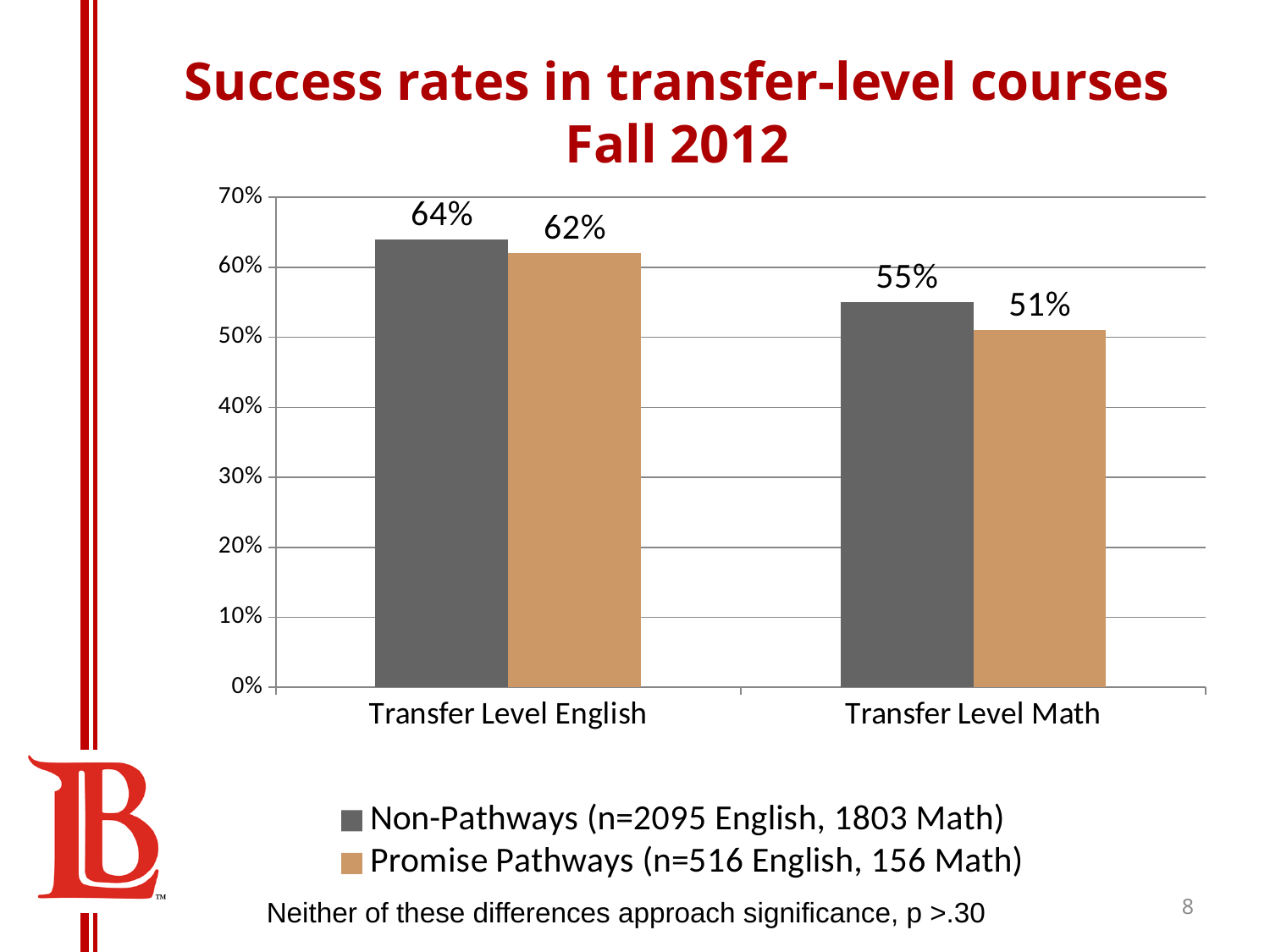
Which is larger: the Promise Pathways rate in Transfer Level English or the Non-Pathways rate in Transfer Level Math? Promise Pathways in Transfer Level English Which category and series has the lowest success rate? Promise Pathways, Transfer Level Math Which category and series has the highest success rate? Non-Pathways, Transfer Level English What kind of chart is shown on the slide? Bar chart How many series does the legend list? 2 How many course categories are shown on the x axis? 2 What is the success rate for Promise Pathways students in Transfer Level English? 62% What is the success rate for Promise Pathways students in Transfer Level Math? 51% What is the difference between the Non-Pathways and Promise Pathways success rates in Transfer Level Math? 4 percentage points What is the success rate for Non-Pathways students in Transfer Level English? 64% What is the title of the chart? Success rates in transfer-level courses Fall 2012 What is the success rate for Non-Pathways students in Transfer Level Math? 55%